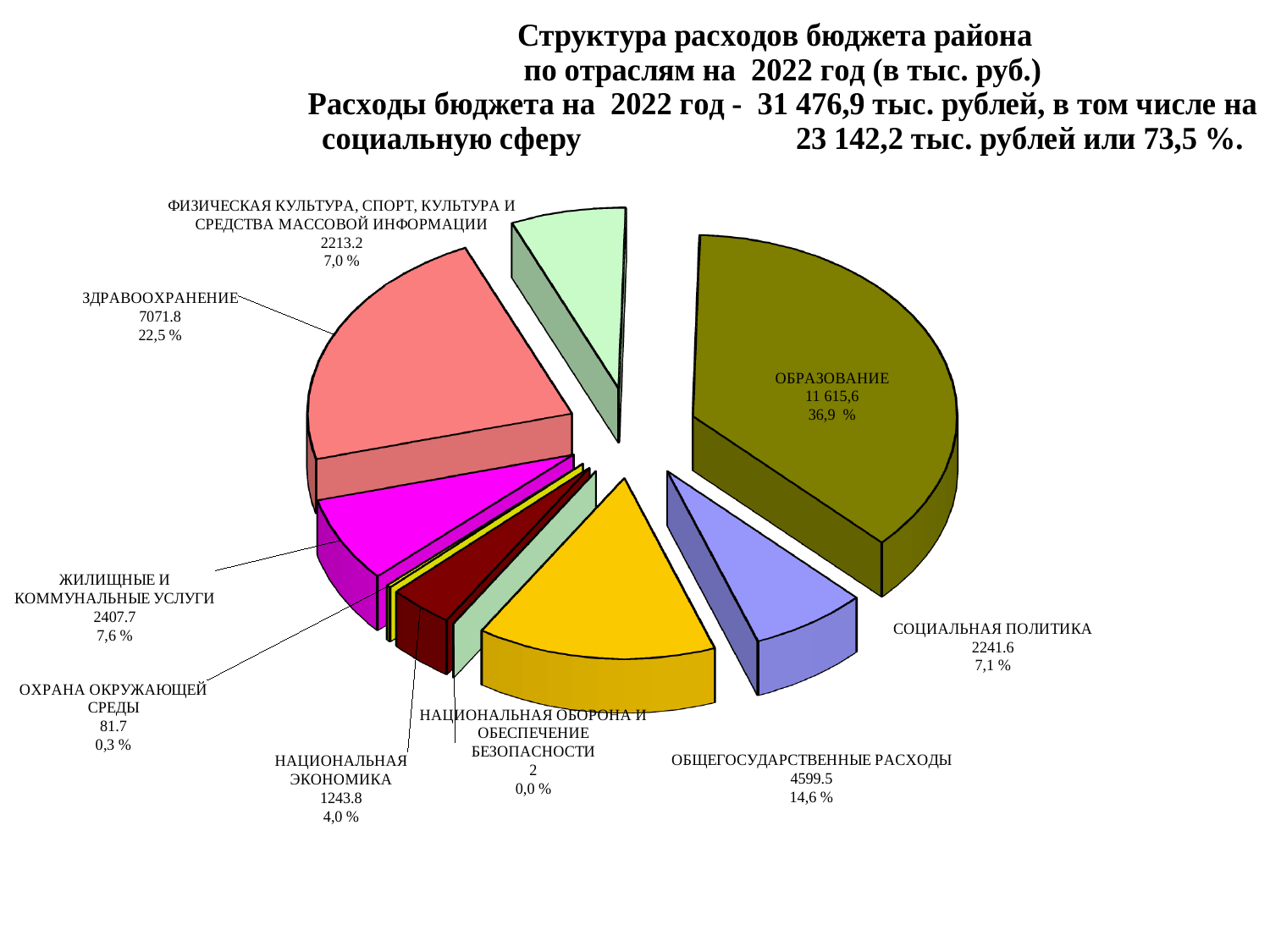
Which category has the largest slice of the pie? ОБРАЗОВАНИЕ What share of the pie does ЗДРАВООХРАНЕНИЕ represent? 22,5 % Which category has the smallest slice of the pie? НАЦИОНАЛЬНАЯ ОБОРОНА И ОБЕСПЕЧЕНИЕ БЕЗОПАСНОСТИ What is the title of the chart? Структура расходов бюджета района по отраслям на 2022 год (в тыс. руб.) Расходы бюджета на 2022 год - 31 476,9 тыс. рублей, в том числе на социальную сферу 23 142,2 тыс. рублей или 73,5 %. What type of chart is shown on the slide? pie chart How many categories are shown in the pie chart? 9 What is the difference between the values for ЗДРАВООХРАНЕНИЕ and ОБЩЕГОСУДАРСТВЕННЫЕ РАСХОДЫ? 2472.3 Which is larger: ЖИЛИЩНЫЕ И КОММУНАЛЬНЫЕ УСЛУГИ or НАЦИОНАЛЬНАЯ ЭКОНОМИКА? ЖИЛИЩНЫЕ И КОММУНАЛЬНЫЕ УСЛУГИ What share of the pie does СОЦИАЛЬНАЯ ПОЛИТИКА represent? 7,1 % What is the value for ОБЩЕГОСУДАРСТВЕННЫЕ РАСХОДЫ? 4599.5 What is the value for ОХРАНА ОКРУЖАЮЩЕЙ СРЕДЫ? 81.7 What is the value for ОБРАЗОВАНИЕ? 11 615,6